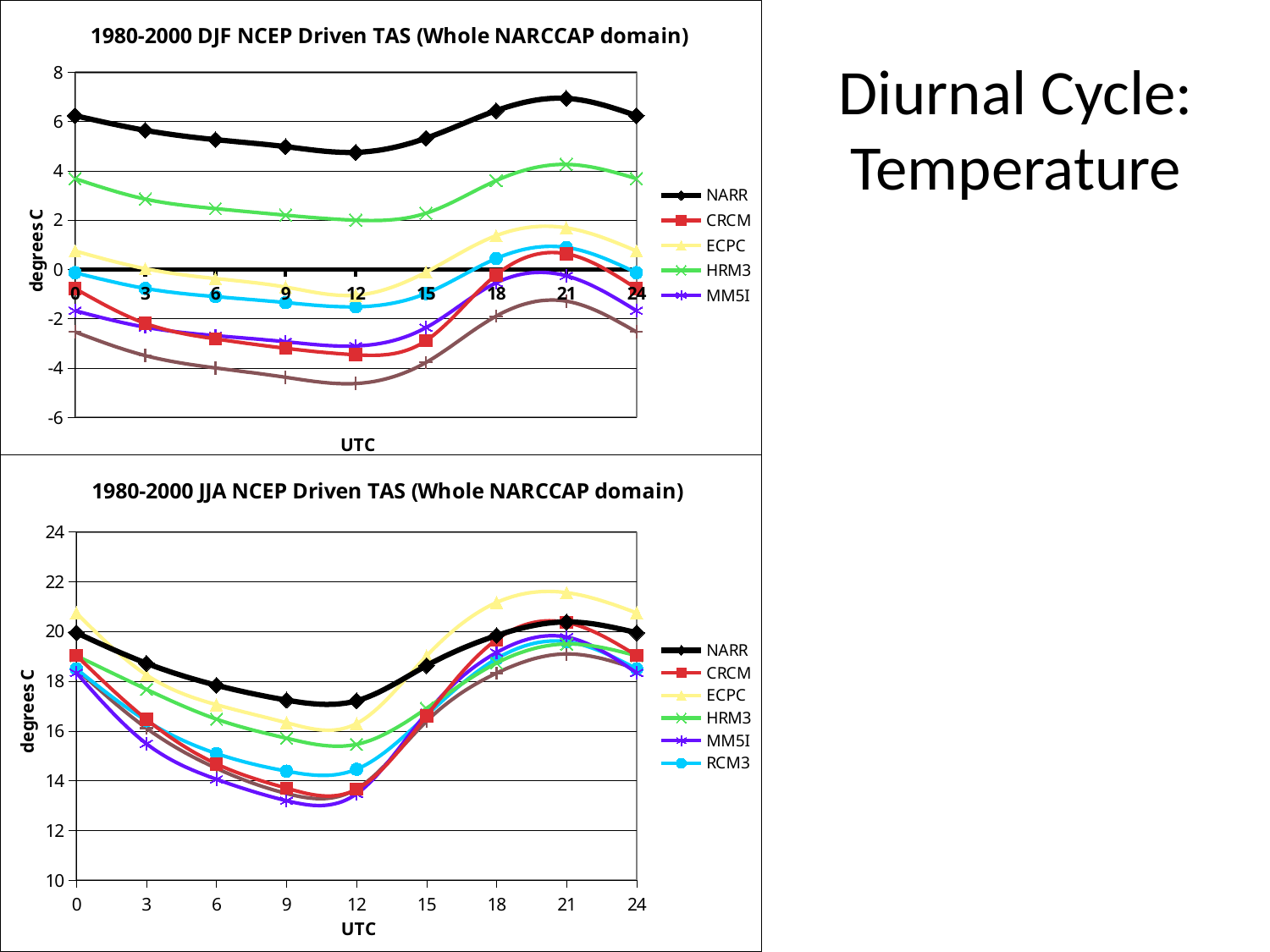
In the bottom chart (JJA), how many UTC points are plotted along the x axis? 9 In the bottom chart (JJA), is the NARR value at 12 UTC greater or less than 18? less In the top chart (DJF), which series has the highest values across the whole diurnal cycle? NARR In the bottom chart (JJA), which series reaches the highest value at 21 UTC? ECPC In the top chart (DJF), which is larger at 21 UTC, ECPC or CRCM? ECPC In the bottom chart (JJA), does the NARR series rise or fall from 0 UTC to 12 UTC? Fall What is the label of the y axis on the bottom chart (JJA)? degrees C How many series does the legend of the top chart (DJF) list? 5 In the top chart (DJF), is the NARR value at 12 UTC greater or less than 4? greater What type of chart is the top chart, '1980-2000 DJF NCEP Driven TAS (Whole NARCCAP domain)'? Line chart In the top chart (DJF), is the CRCM value at 12 UTC greater or less than -2? less How many series does the legend of the bottom chart, '1980-2000 JJA NCEP Driven TAS (Whole NARCCAP domain)', list? 6